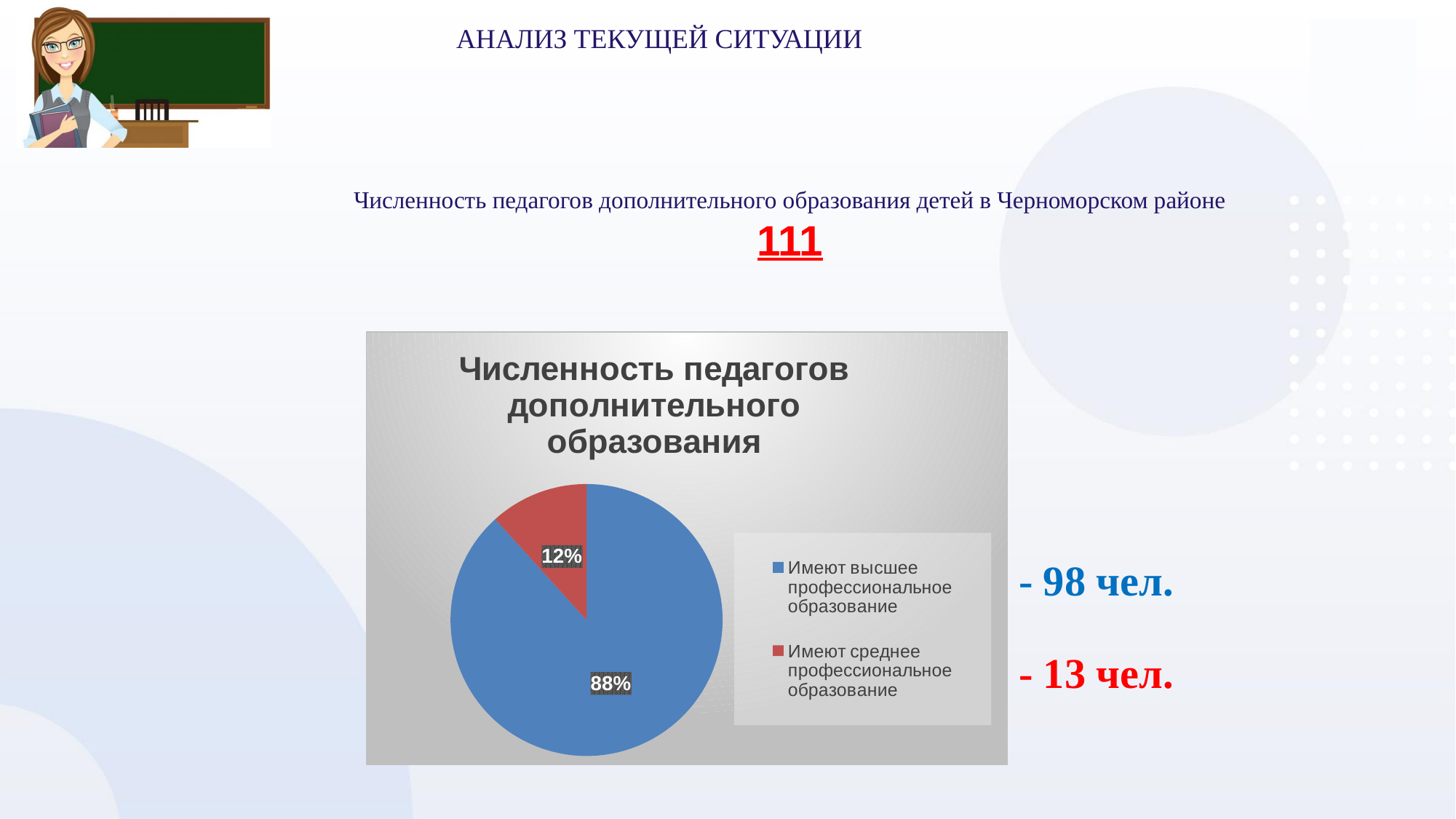
What is the difference in percentage points between the 'Имеют высшее профессиональное образование' slice and the 'Имеют среднее профессиональное образование' slice? 76 percentage points Which category has the largest slice of the pie? Имеют высшее профессиональное образование Which slice is larger: 'Имеют высшее профессиональное образование' or 'Имеют среднее профессиональное образование'? Имеют высшее профессиональное образование What colour is the slice for 'Имеют среднее профессиональное образование'? red What is the value printed on the slice for 'Имеют высшее профессиональное образование'? 88% How many entries does the chart legend list? 2 Which category has the smallest slice of the pie? Имеют среднее профессиональное образование What share of the pie is labelled for 'Имеют среднее профессиональное образование'? 12% What type of chart is shown on the slide? pie chart What share of the pie is labelled for 'Имеют высшее профессиональное образование'? 88% What is the title of the chart? Численность педагогов дополнительного образования How many slices does the pie chart have? 2